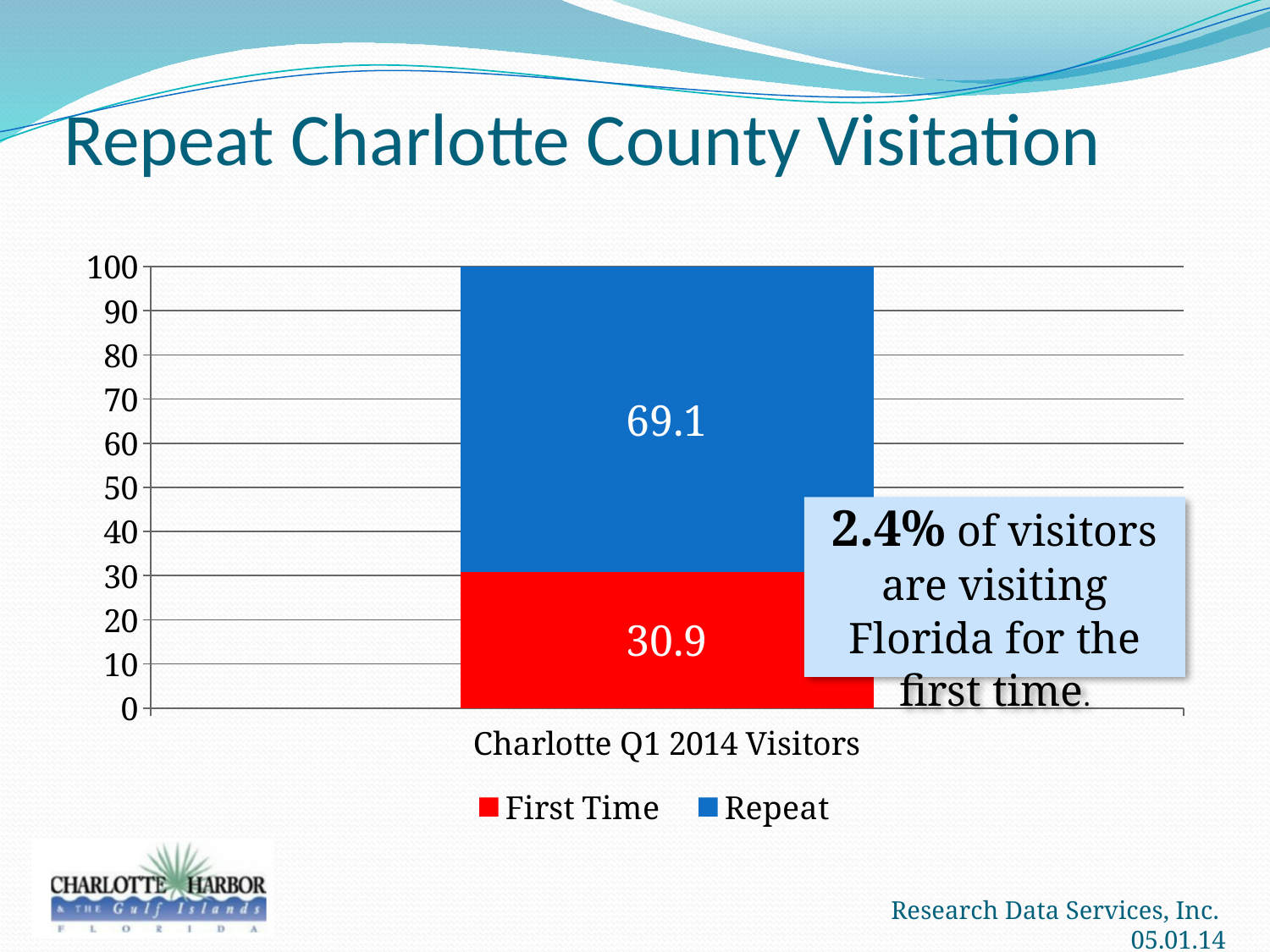
What is the highest value shown on the y axis? 100 What is the difference between the Repeat value and the First Time value? 38.2 Which colour represents the Repeat series? Blue How many series does the legend list? 2 What is the value for Repeat visitors in the chart? 69.1 How many categories are shown on the x axis? 1 Which series has the larger value, First Time or Repeat? Repeat What is the total of the stacked bar for Charlotte Q1 2014 Visitors? 100 What kind of chart is shown on the slide? Stacked bar chart What is the category label on the x axis? Charlotte Q1 2014 Visitors Is the value for First Time greater or less than 40? less What is the value for First Time visitors in the chart? 30.9